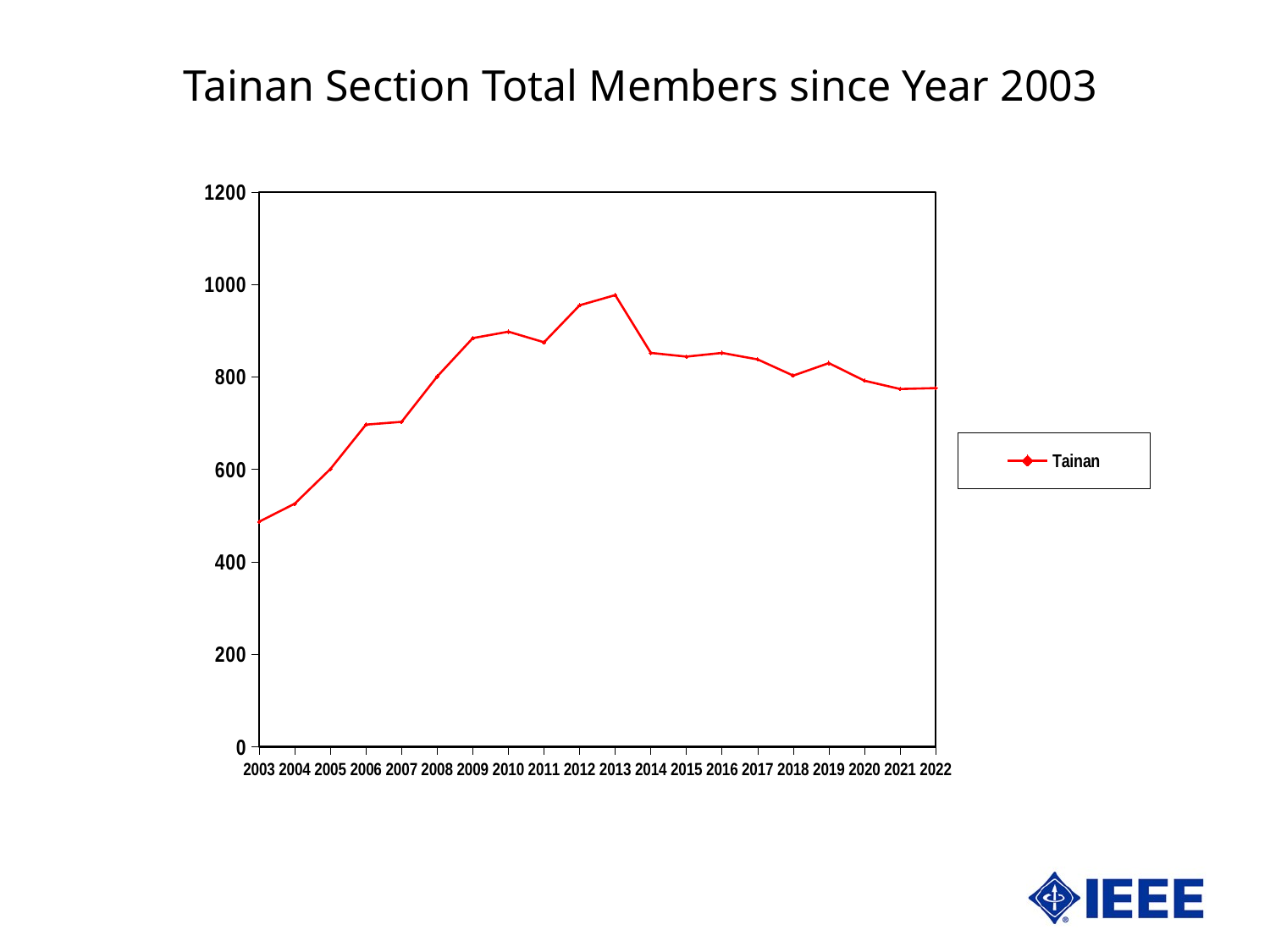
Is the value for 2013 greater or less than 1000? less What is the name of the series shown in the legend? Tainan What kind of chart is shown on the slide? line chart How many years are plotted along the x axis? 20 In which year is the number of Tainan members highest? 2013 Which year has more members, 2009 or 2005? 2009 How many series does the legend list? 1 What is the title of the chart? Tainan Section Total Members since Year 2003 Do the values rise or fall from 2003 to 2009? rise Is the value for 2009 greater or less than 800? greater Is the value for 2003 greater or less than 600? less In which year is the number of Tainan members lowest? 2003